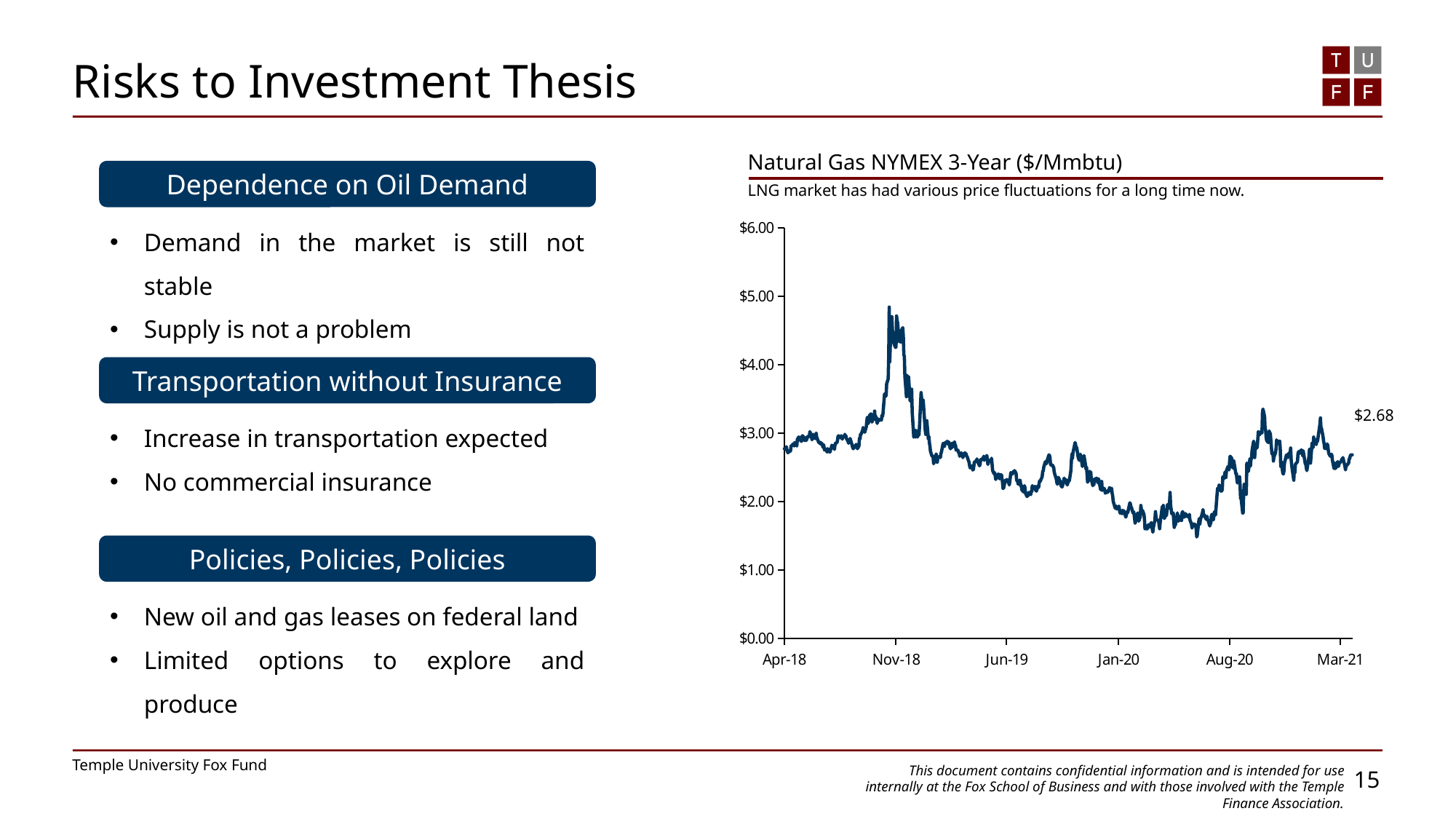
Does the natural gas price rise or fall between its Nov-18 peak and Jan-20? fall What is the highest value shown on the y axis? $6.00 Around which x-axis label does the natural gas price reach its highest point? Nov-18 What is the title of the chart? Natural Gas NYMEX 3-Year ($/Mmbtu) Is the lowest natural gas price, reached between Jan-20 and Aug-20, greater or less than $2.00? less What kind of chart is shown on the slide? Line chart Is the natural gas price at Apr-18 greater or less than $2.00? greater What is the last data value labelled on the chart, at Mar-21? $2.68 Is the peak value of the natural gas price near Nov-18 greater or less than $4.00? greater How many date labels are shown on the x axis? 6